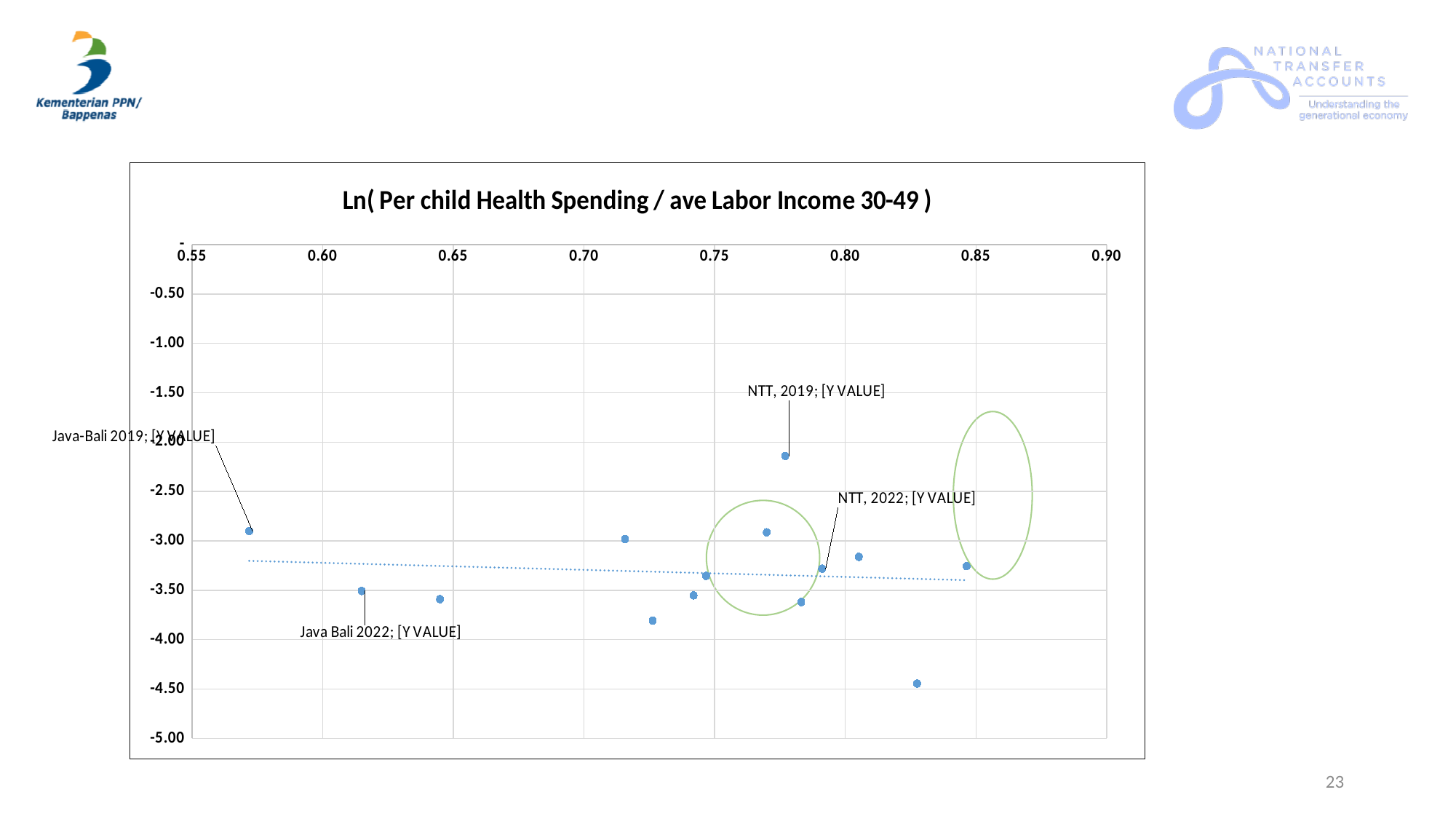
Does the dotted trend line rise or fall as the x value increases? Falls What is the lowest value shown on the y axis of the chart? -5.00 How many data points are plotted on the chart? 14 Is the y value for the Java-Bali 2019 point greater or less than -2.50? less Is the y value for the Java Bali 2022 point greater or less than -3.00? less What kind of chart is shown on the slide? Scatter chart Which has the higher y value, Java-Bali 2019 or Java Bali 2022? Java-Bali 2019 What is the title of the chart? Ln( Per child Health Spending / ave Labor Income 30-49 ) Which labelled point has the highest y value on the chart? NTT, 2019 Is the y value for the NTT, 2022 point greater or less than -3.00? less Which has the higher y value, NTT, 2019 or NTT, 2022? NTT, 2019